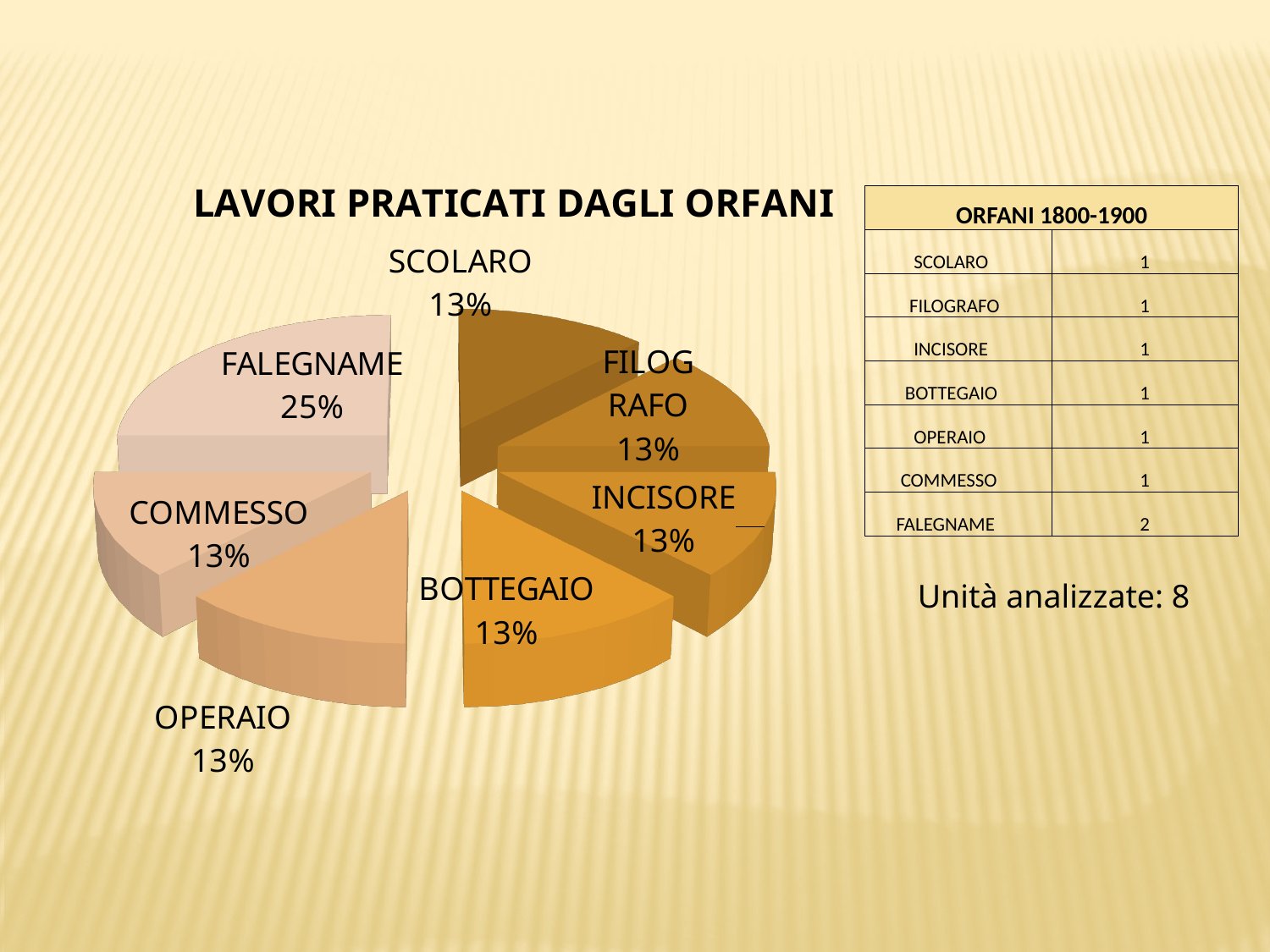
Is the share for FALEGNAME greater or less than 20%? greater Which is larger, the slice for FALEGNAME or the slice for COMMESSO? FALEGNAME What percentage is shown for SCOLARO? 13% What is the difference in percentage points between FALEGNAME and INCISORE? 12 What is the title of the chart? LAVORI PRATICATI DAGLI ORFANI What percentage is shown for OPERAIO? 13% Which category has the largest slice of the pie? FALEGNAME What percentage is shown for BOTTEGAIO? 13% What share of the pie does FALEGNAME represent? 25% What type of chart is shown on the slide? Pie chart What percentage is shown for FILOGRAFO? 13% How many slices does the pie chart have? 7